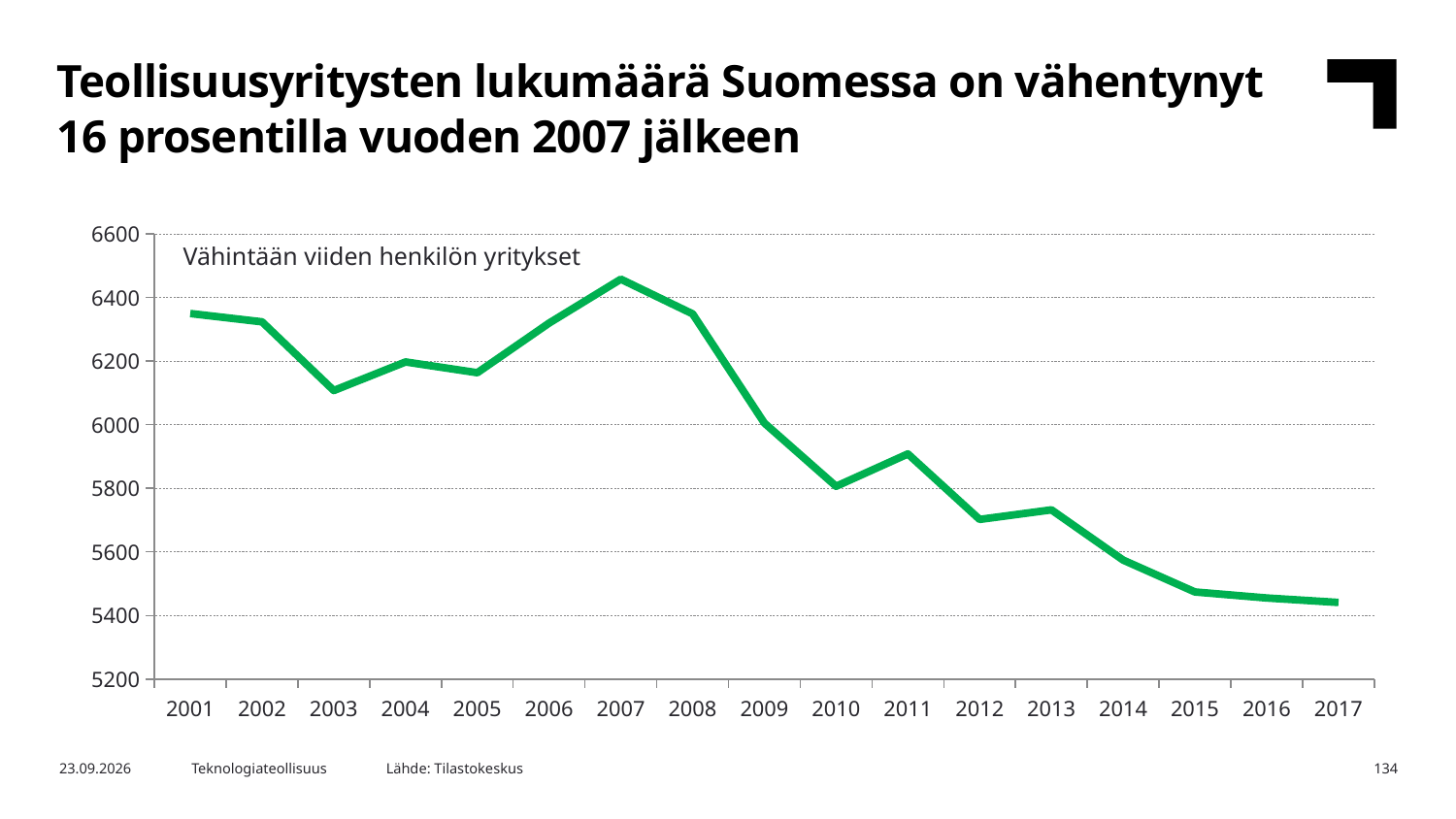
What colour is the plotted line? green Overall, do the values rise or fall from 2001 to 2017? fall Is the value for 2003 greater or less than 6000? greater How many years are plotted along the x axis? 17 What kind of chart is shown on the slide? line chart Which year has the larger value, 2010 or 2011? 2011 Is the value for 2010 greater or less than 6000? less Which year has the larger value, 2003 or 2004? 2004 Is the value for 2007 greater or less than 6400? greater What text label is shown inside the plot area of the chart? Vähintään viiden henkilön yritykset Which year has the highest value on the chart? 2007